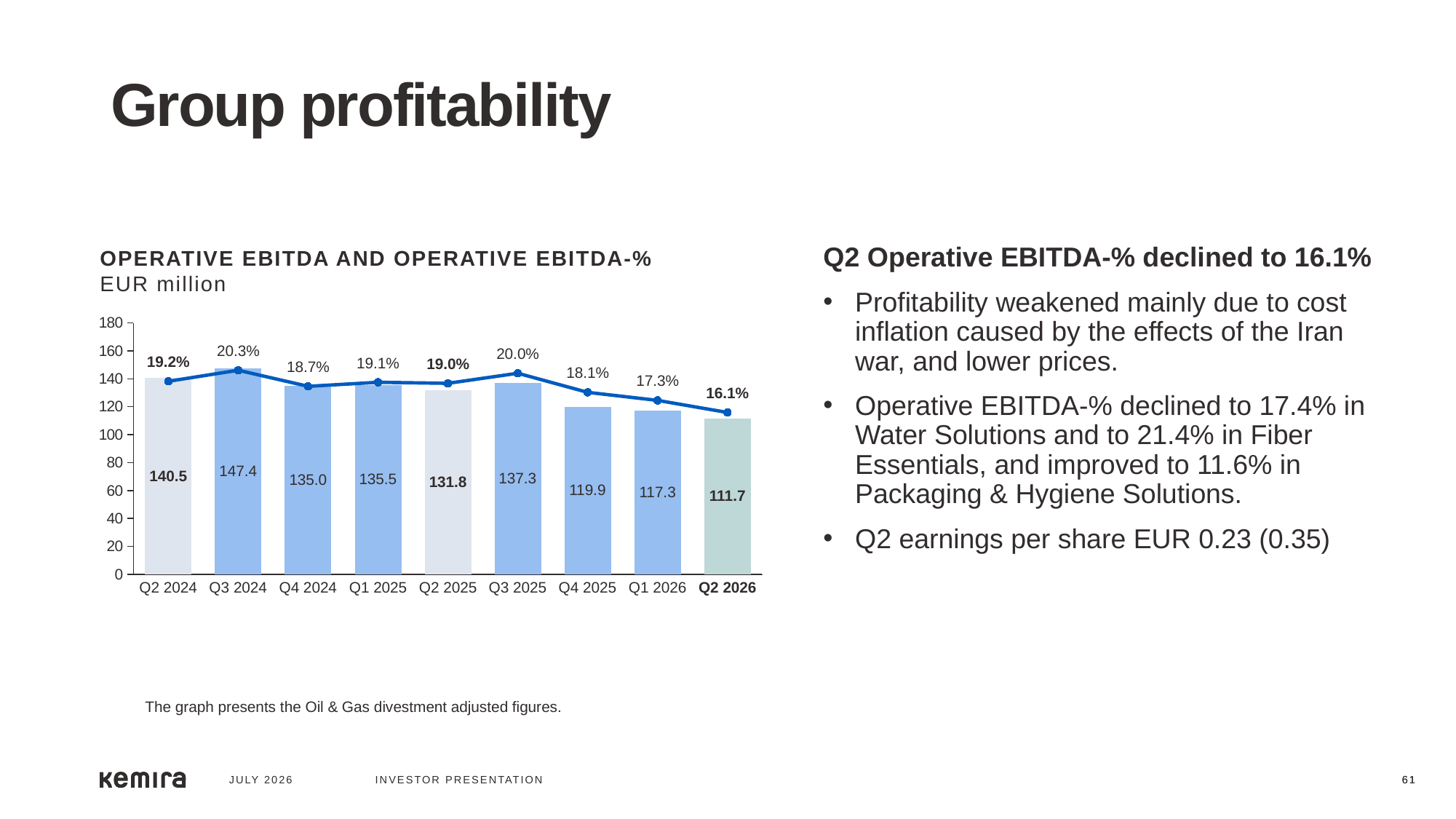
Does the Operative EBITDA-% line rise or fall from Q3 2025 to Q2 2026? Fall Is the Operative EBITDA bar for Q1 2026 greater or less than 120 EUR million? less What is the title of the chart? OPERATIVE EBITDA AND OPERATIVE EBITDA-% What is the Operative EBITDA in EUR million for Q4 2025? 119.9 What is the Operative EBITDA-% for Q3 2024? 20.3% How many quarters are shown on the x axis of the chart? 9 What is the Operative EBITDA in EUR million for Q2 2026? 111.7 Which quarter has the lowest Operative EBITDA-%? Q2 2026 What is the difference in Operative EBITDA (EUR million) between Q2 2025 and Q2 2026? 20.1 Which quarter has the larger Operative EBITDA in EUR million, Q1 2025 or Q3 2025? Q3 2025 Which quarter has the highest Operative EBITDA in EUR million? Q3 2024 What kind of chart is used to show Operative EBITDA in EUR million? Bar chart